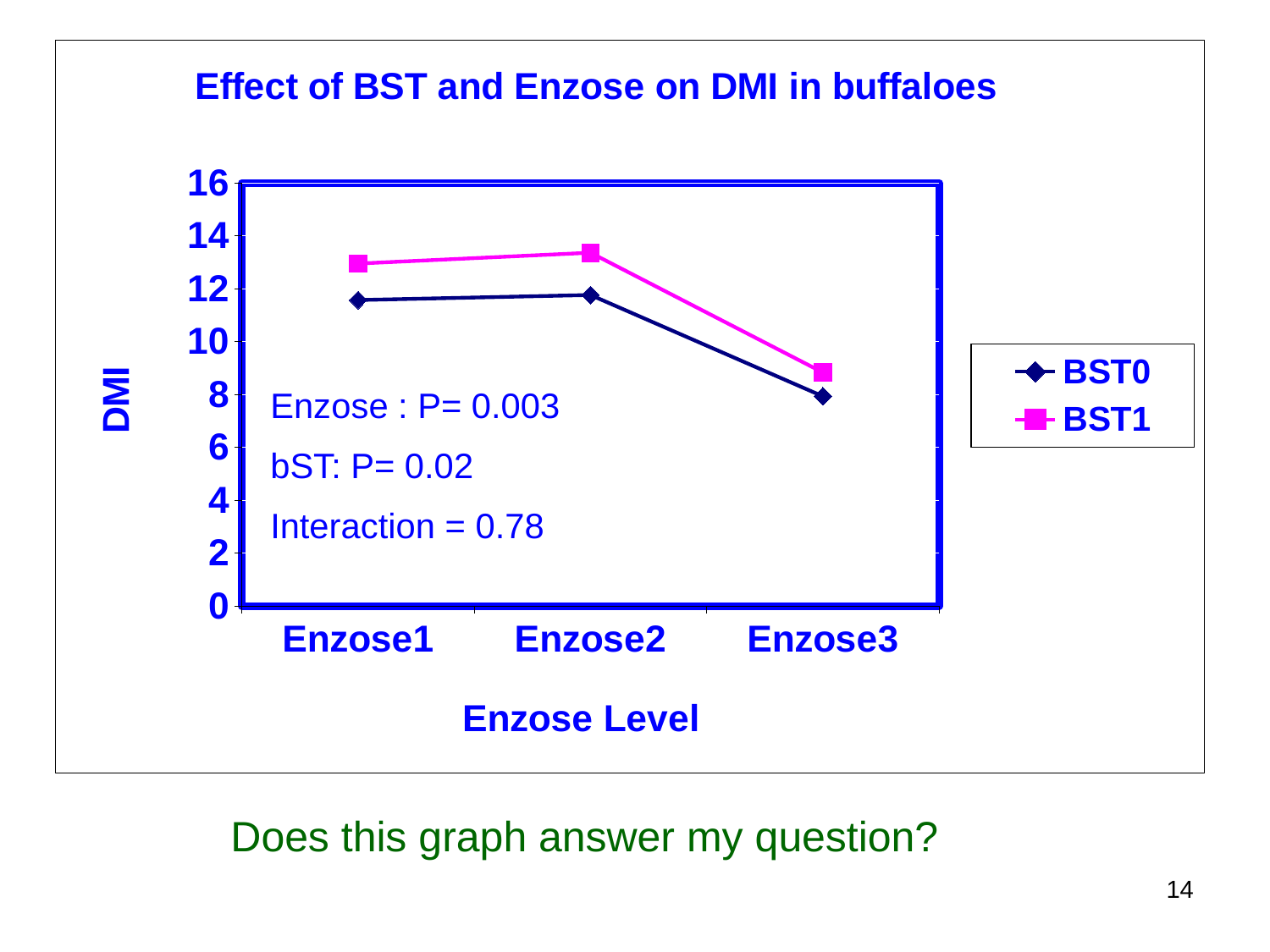
At Enzose1, which series has the higher DMI, BST0 or BST1? BST1 Is the DMI for BST0 at Enzose1 greater or less than 12? less Is the DMI for BST1 at Enzose1 greater or less than 12? greater At which Enzose level is the DMI for BST0 lowest? Enzose3 At which Enzose level is the DMI for BST1 lowest? Enzose3 What is the title of the chart? Effect of BST and Enzose on DMI in buffaloes How many Enzose levels are plotted along the x axis? 3 Is the DMI for BST0 at Enzose3 greater or less than 10? less How many series does the legend list? 2 Does the DMI for BST0 rise or fall from Enzose2 to Enzose3? fall At which Enzose level is the DMI for BST1 highest? Enzose2 What kind of chart is shown on the slide? line chart